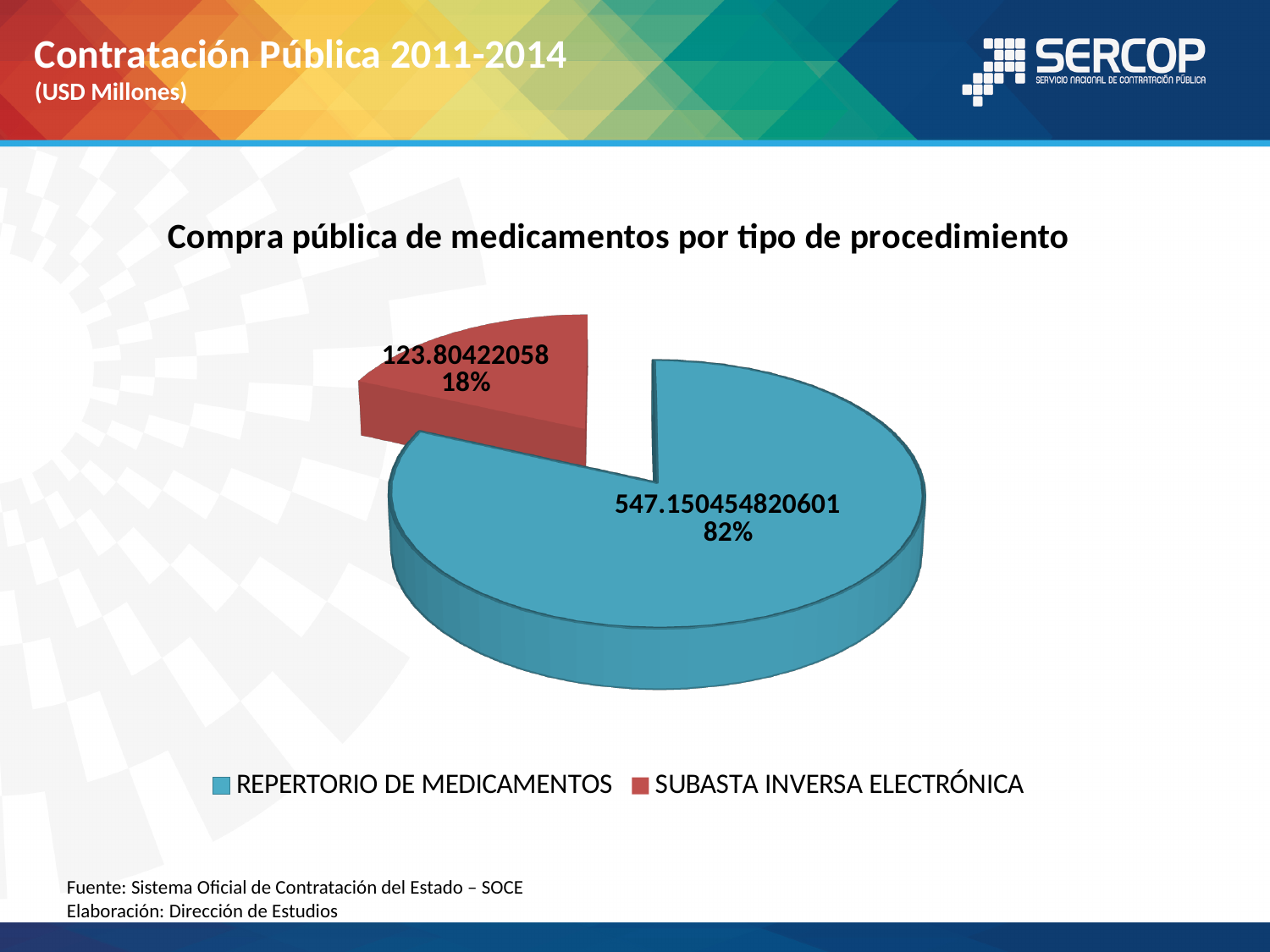
What is the title of the chart? Compra pública de medicamentos por tipo de procedimiento What share of the pie does REPERTORIO DE MEDICAMENTOS represent? 82% How many categories does the pie chart show? 2 Which category has the smallest slice of the pie? SUBASTA INVERSA ELECTRÓNICA What type of chart is shown on the slide? Pie chart Which category has the largest slice of the pie? REPERTORIO DE MEDICAMENTOS Which is larger, REPERTORIO DE MEDICAMENTOS or SUBASTA INVERSA ELECTRÓNICA? REPERTORIO DE MEDICAMENTOS What is the value for SUBASTA INVERSA ELECTRÓNICA? 123.80422058 What colour is the slice for SUBASTA INVERSA ELECTRÓNICA? Red How many entries does the legend list? 2 What share of the pie does SUBASTA INVERSA ELECTRÓNICA represent? 18% What is the value for REPERTORIO DE MEDICAMENTOS? 547.150454820601